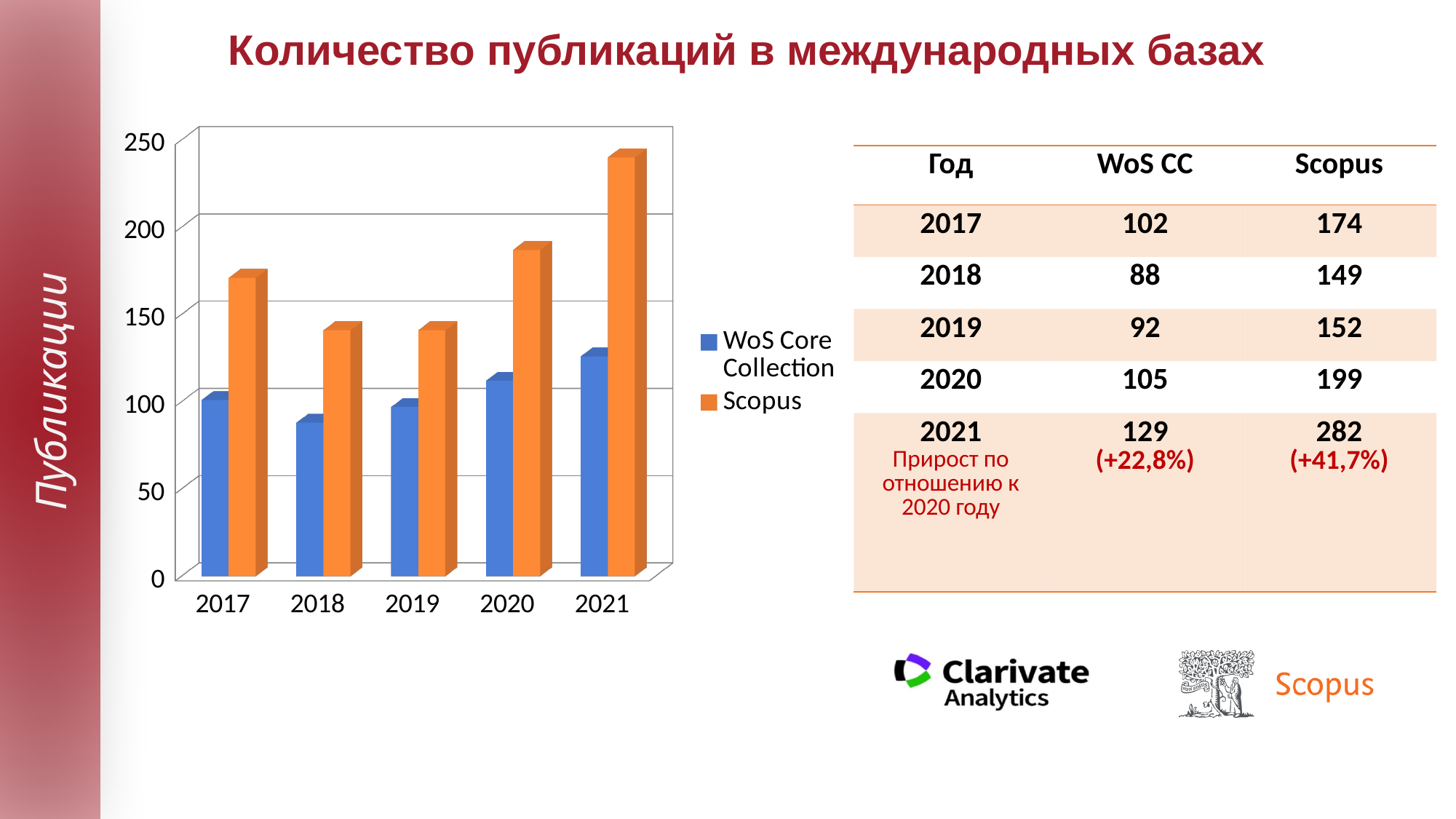
What is the difference between the Scopus and WoS Core Collection values in 2020? 94 Which year has the highest Scopus value? 2021 What kind of chart is shown on the slide? bar chart What is the WoS Core Collection value for 2018? 88 What is the Scopus value for 2021? 282 Do the Scopus values rise or fall from 2019 to 2021? rise How many series does the chart legend list? 2 What colour are the Scopus bars in the chart? orange Which is larger in 2017, the Scopus value or the WoS Core Collection value? Scopus How many years are shown on the x axis of the chart? 5 Which year has the lowest WoS Core Collection value? 2018